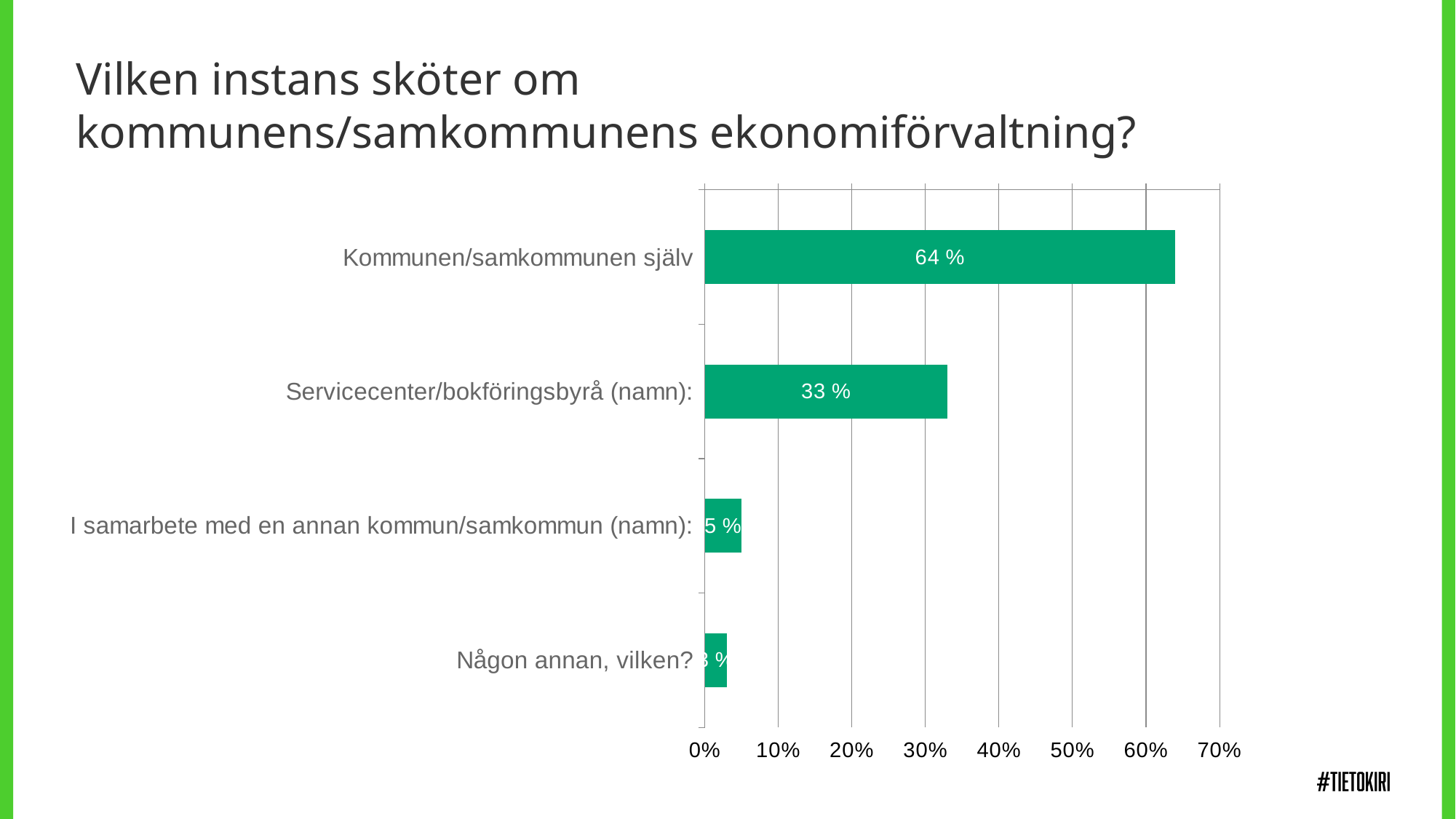
How many categories are shown in the chart? 4 What is the value for I samarbete med en annan kommun/samkommun (namn)? 5 % What colour are the bars in the chart? green Which category has the highest value? Kommunen/samkommunen själv Is the value for Kommunen/samkommunen själv greater or less than 60%? greater What is the value for Kommunen/samkommunen själv? 64 % What is the difference between the values for Kommunen/samkommunen själv and Servicecenter/bokföringsbyrå (namn)? 31 % Is the value for Någon annan, vilken? greater or less than 10%? less Which is larger: the value for Servicecenter/bokföringsbyrå (namn) or the value for I samarbete med en annan kommun/samkommun (namn)? Servicecenter/bokföringsbyrå (namn) What is the value for Servicecenter/bokföringsbyrå (namn)? 33 % Which category has the lowest value? Någon annan, vilken? What kind of chart is shown on the slide? bar chart